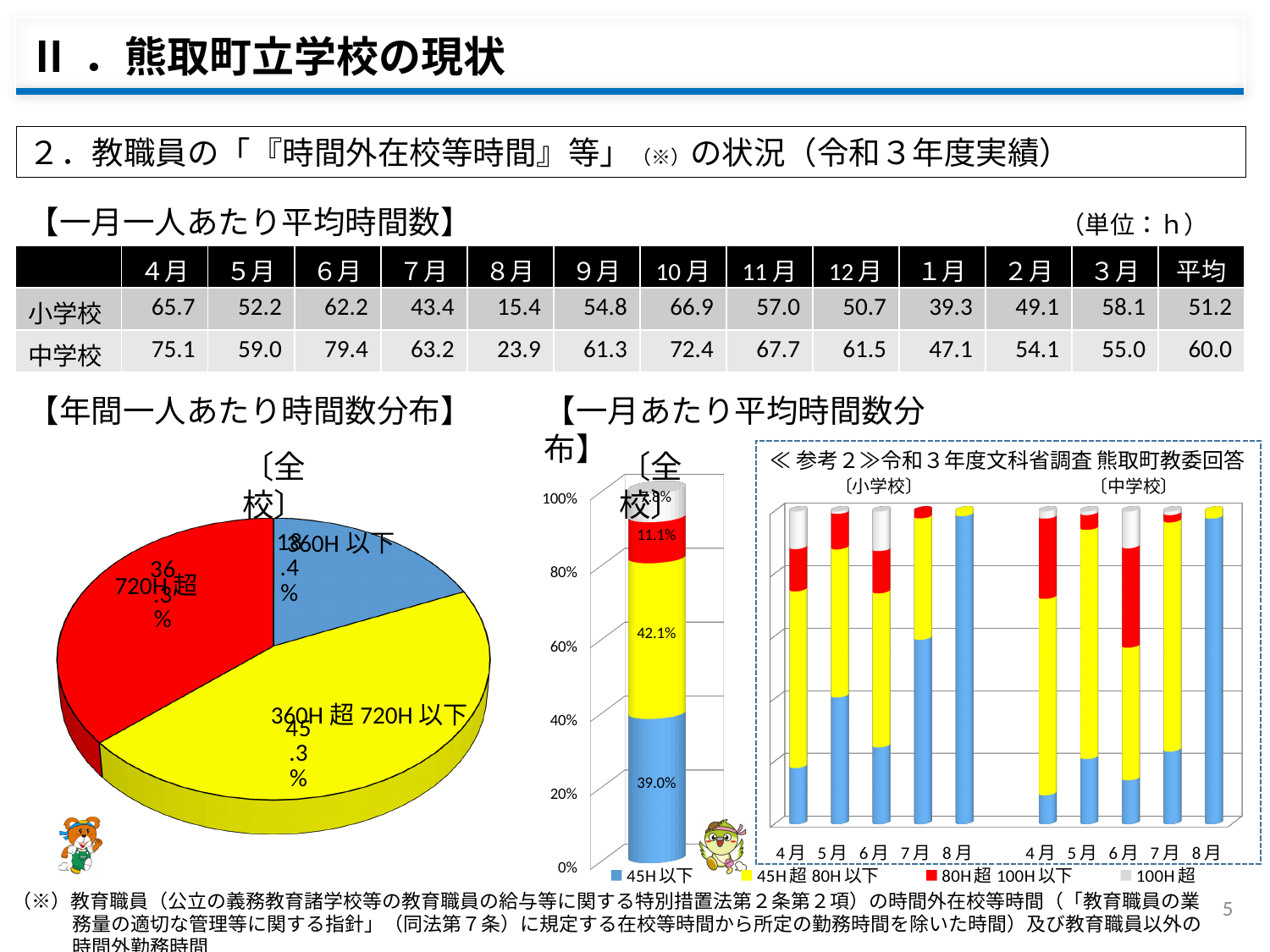
In the pie chart 【年間一人あたり時間数分布】, what share is labelled for 360H 以下? 18.4% In the pie chart 【年間一人あたり時間数分布】, which category has the smallest share? 360H 以下 In the stacked bar chart 【一月あたり平均時間数分布】 (全校), what percentage is shown for 45H 以下? 39.0% In the pie chart 【年間一人あたり時間数分布】, what share is labelled for 720H 超? 36.3% In the pie chart 【年間一人あたり時間数分布】, how many slices are there? 3 In the stacked bar chart 【一月あたり平均時間数分布】 (全校), how many series does the legend list? 4 In the stacked bar chart 【一月あたり平均時間数分布】 (全校), what percentage is shown for 80H 超 100H 以下? 11.1% In the ≪参考2≫ chart, is the 45H 以下 share for 小学校 in 8月 greater or less than 80%? greater In the pie chart 【年間一人あたり時間数分布】, which category has the largest share? 360H 超 720H 以下 What kind of chart is the 【年間一人あたり時間数分布】 chart? pie chart In the pie chart 【年間一人あたり時間数分布】, what share is labelled for 360H 超 720H 以下? 45.3% In the stacked bar chart 【一月あたり平均時間数分布】 (全校), what percentage is shown for 45H 超 80H 以下? 42.1%